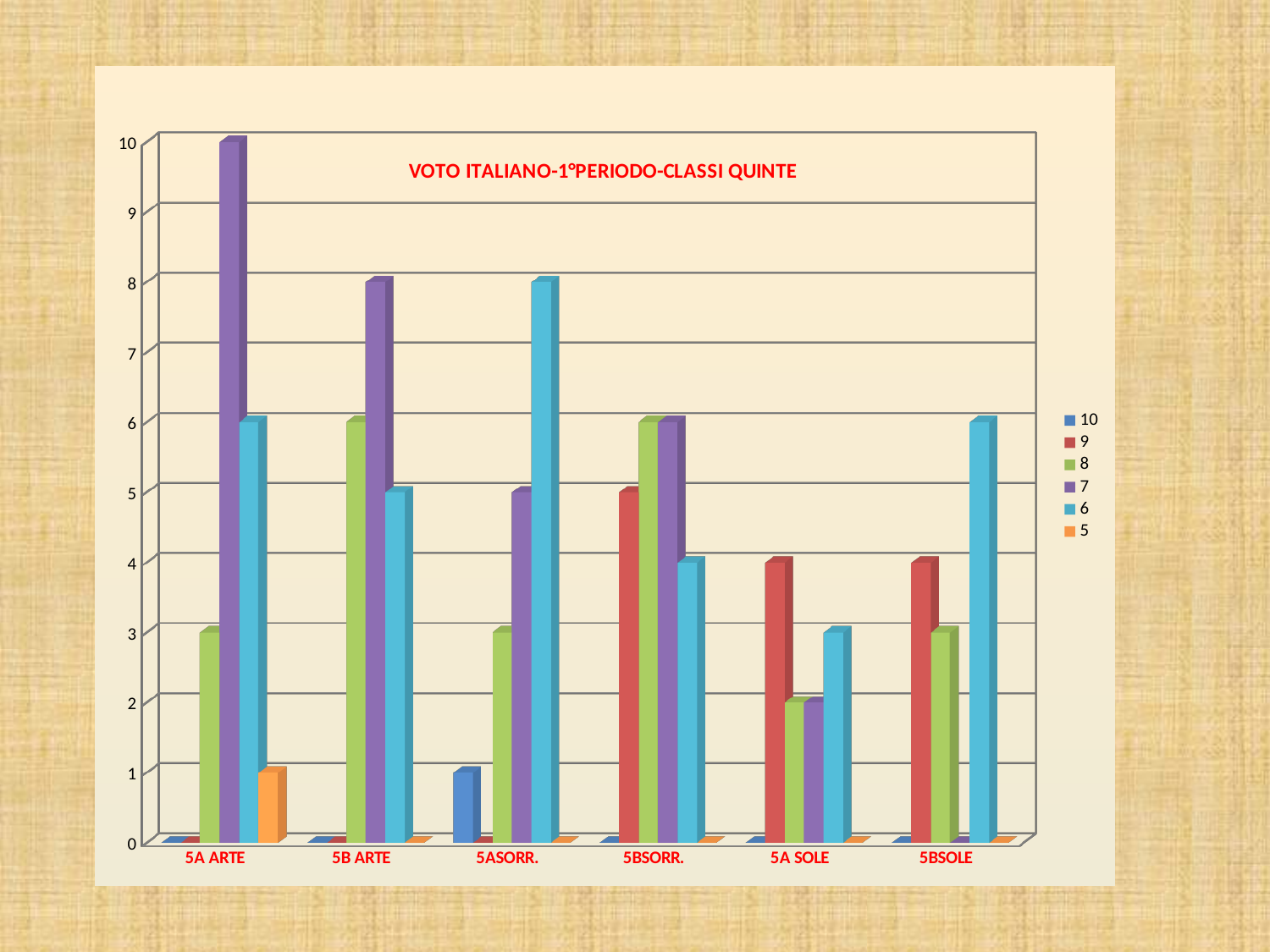
What is the title of the chart? VOTO ITALIANO-1°PERIODO-CLASSI QUINTE Is the value of series 7 for 5B ARTE greater or less than 7? greater What is the value of series 6 for 5ASORR.? 8 How many classes (categories) are shown on the x axis? 6 What is the value of series 5 for 5A ARTE? 1 Which class has the highest bar for series 7? 5A ARTE What is the value of series 7 for 5A ARTE? 10 Which class has the lowest bar for series 6? 5A SOLE How many series does the legend list? 6 What kind of chart is shown on the slide? bar chart Which is larger for 5BSORR.: series 9 or series 6? series 9 Which class is the only one with a visible bar for series 10? 5ASORR.